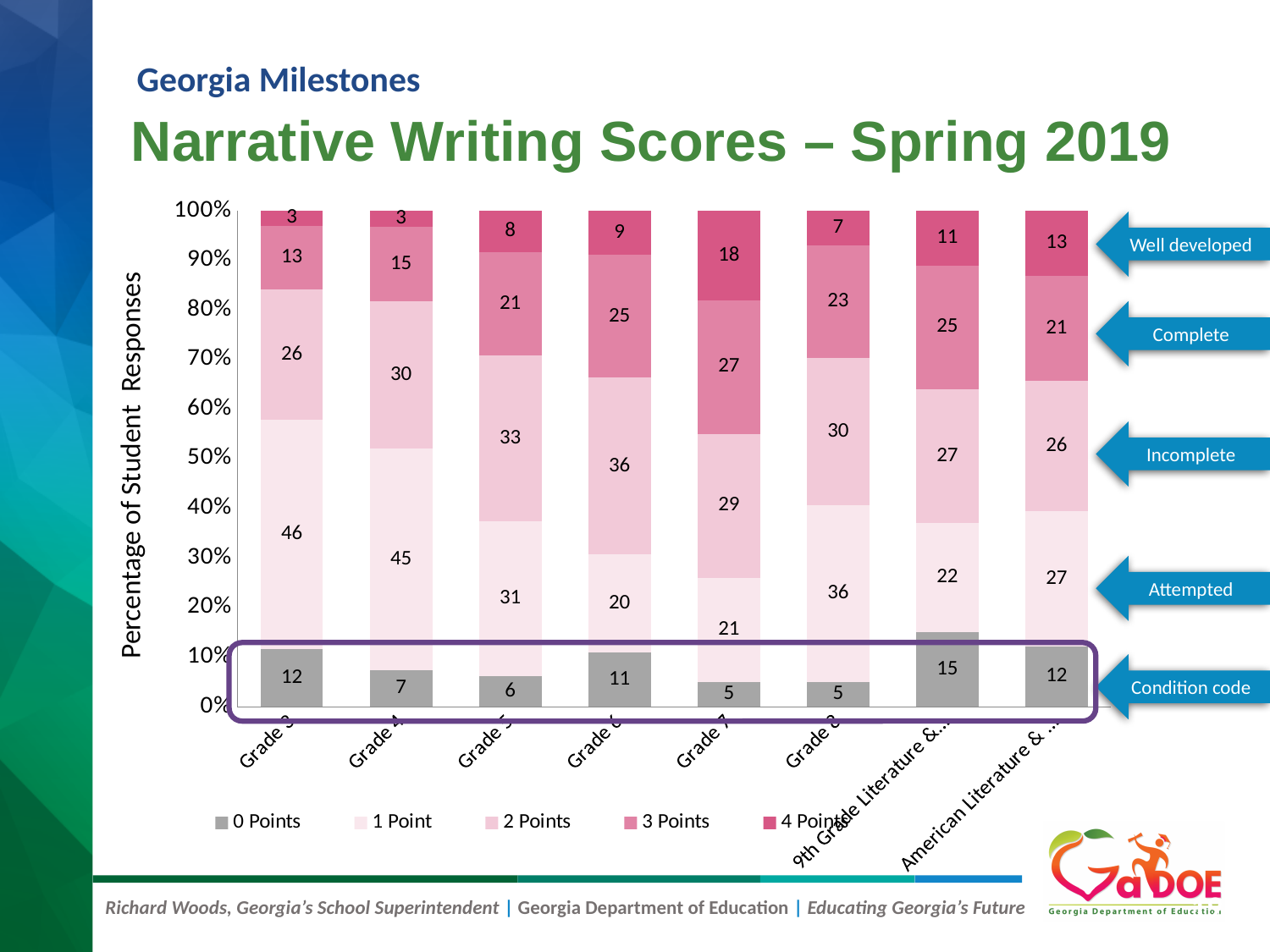
What type of chart is shown on the slide? Stacked bar chart Which has a larger 3 Points value, Grade 5 or Grade 6? Grade 6 What is the value of the 0 Points segment for Grade 6? 11 Which grade has the highest 4 Points value? Grade 7 Which grade has the lowest 4 Points value? Grade 3 and Grade 4 (both 3) What is the value of the 2 Points segment for Grade 8? 30 What is the value of the 4 Points segment for Grade 7? 18 What is the difference between the 4 Points values for Grade 7 and Grade 8? 11 How many series does the legend list? 5 What percentage of Grade 3 student responses scored 1 Point? 46 How many bars (categories) are shown in the chart? 8 What is the difference between the 2 Points values for Grade 4 and Grade 3? 4